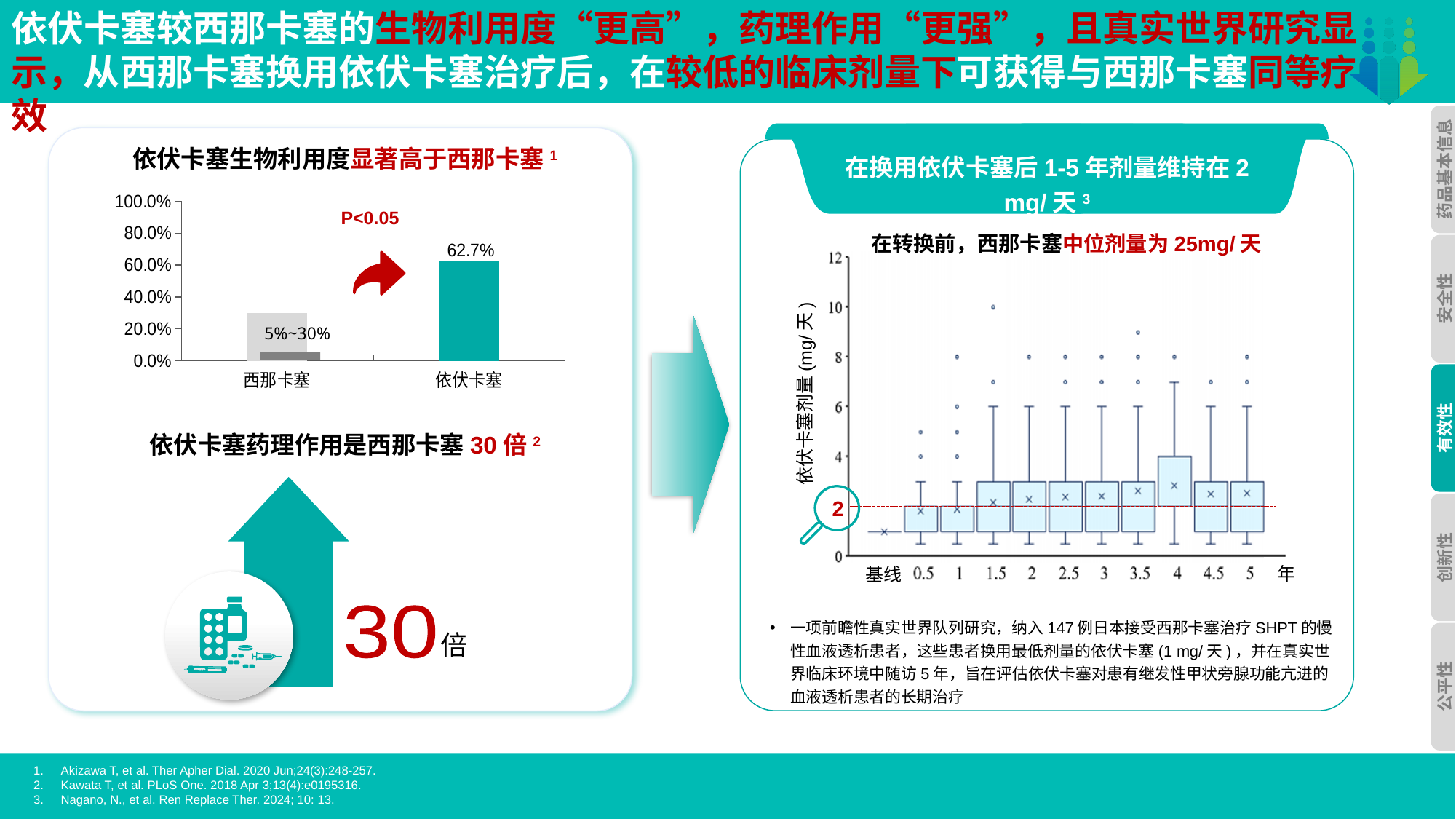
What kind of chart is the chart on the right of the slide? box plot In the bar chart on the left, what value label is shown for 西那卡塞? 5%~30% In the bar chart on the left, which is larger, the bar for 依伏卡塞 or the bar for 西那卡塞? 依伏卡塞 In the box plot on the right, is the value at 基线 greater or less than 2? less In the bar chart on the left, which category has the highest bar? 依伏卡塞 In the bar chart on the left, what is the bioavailability value shown for 依伏卡塞? 62.7% In the bar chart on the left, is the value for 依伏卡塞 greater or less than 60.0%? greater What p-value is printed on the bar chart on the left? P<0.05 How many time points are shown on the x axis of the box plot on the right? 11 What is the y-axis label of the box plot on the right? 依伏卡塞剂量 (mg/天) How many categories are shown on the x axis of the bar chart on the left? 2 What kind of chart is the chart on the left of the slide? bar chart